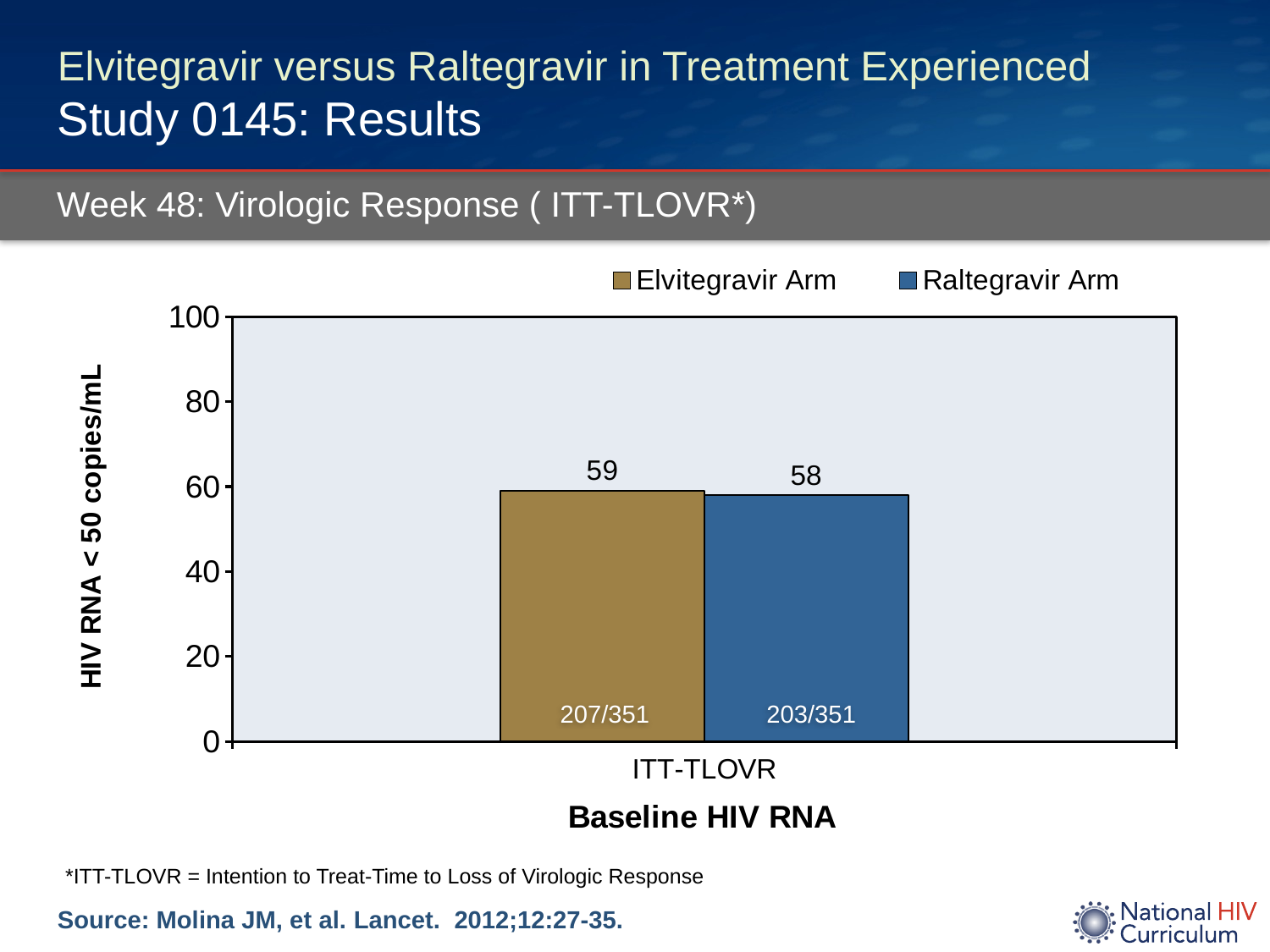
What is the label of the x axis? Baseline HIV RNA What is the value for the Raltegravir Arm in the ITT-TLOVR category? 58 What is the difference between the Elvitegravir Arm and Raltegravir Arm values? 1 Is the value for the Raltegravir Arm greater or less than 80? less What fraction is printed inside the Raltegravir Arm bar? 203/351 How many categories are shown on the x axis? 1 Is the value for the Elvitegravir Arm greater or less than 40? greater What fraction is printed inside the Elvitegravir Arm bar? 207/351 What is the label of the y axis? HIV RNA < 50 copies/mL What kind of chart is shown on the slide? bar chart How many series does the legend list? 2 What is the value for the Elvitegravir Arm in the ITT-TLOVR category? 59